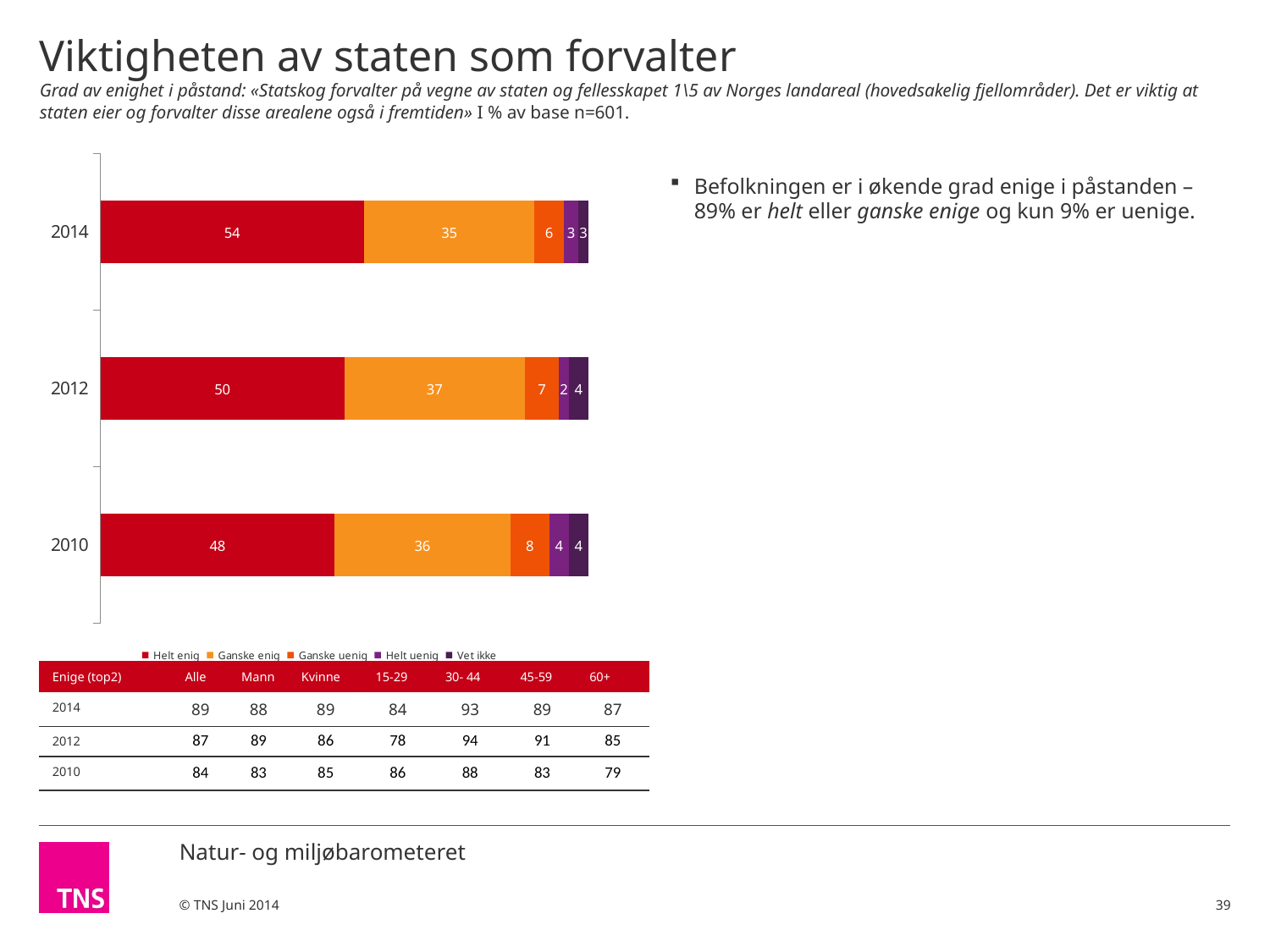
What is the value for Vet ikke in 2012? 4 How many years are shown in the chart? 3 What kind of chart is shown on the slide? Stacked bar chart What is the value for Ganske uenig in 2010? 8 What is the total of the stacked bar for 2012? 100 What is the difference between the Helt enig values for 2014 and 2010? 6 What is the value for Helt enig in 2014? 54 What is the value for Ganske enig in 2012? 37 Which year has the lowest value for Helt enig? 2010 Which year has the highest value for Helt enig? 2014 Which is larger, the Ganske enig value for 2012 or for 2014? 2012 How many series does the legend list? 5